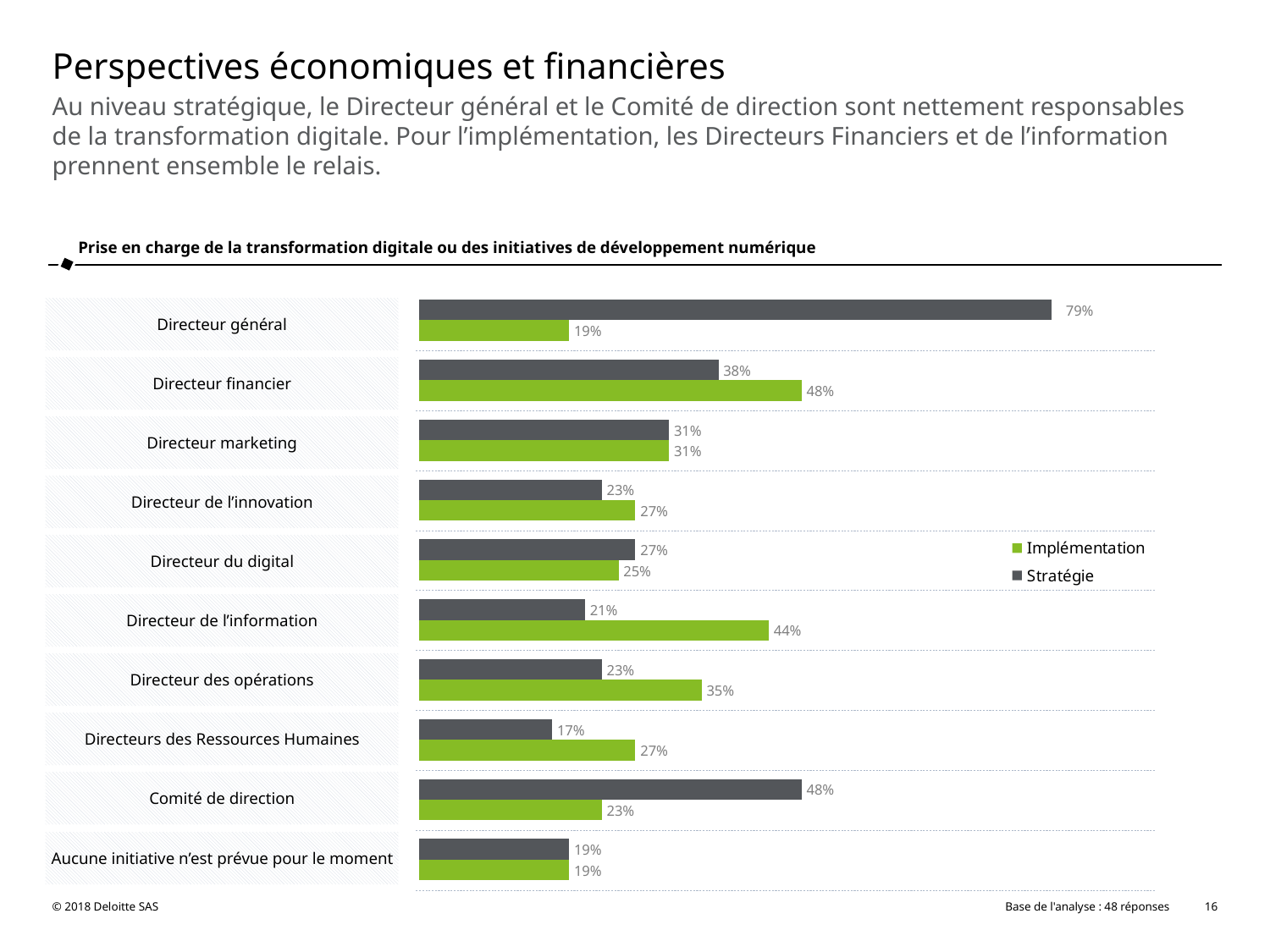
What is the difference between the Stratégie and Implémentation values for Directeur général? 60% Which category has the highest Implémentation value? Directeur financier How many categories are shown on the chart? 10 Which category has the lowest Stratégie value? Directeurs des Ressources Humaines For Comité de direction, which is larger: the Stratégie value or the Implémentation value? Stratégie Which colour represents the Implémentation series? Green Which category has the highest Stratégie value? Directeur général How many series does the legend list? 2 What is the Implémentation value for Directeur de l'information? 44% What is the Stratégie value for Directeur général? 79% What is the Implémentation value for Directeur financier? 48% What kind of chart is shown on the slide? Bar chart